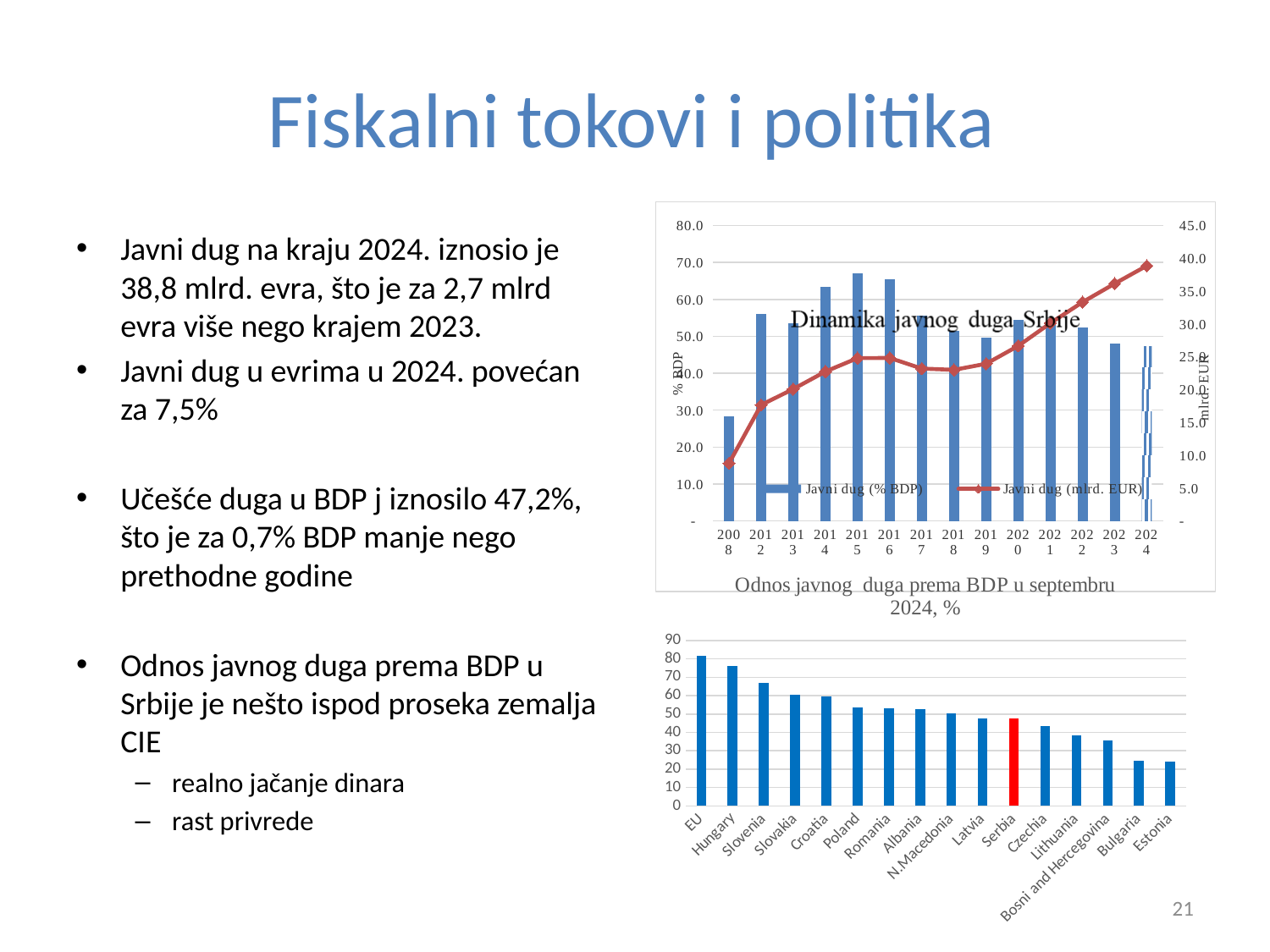
In the bottom chart 'Odnos javnog duga prema BDP u septembru 2024, %', is the value for Serbia greater or less than 50? less In the bottom chart 'Odnos javnog duga prema BDP u septembru 2024, %', how many countries/categories are shown? 16 In the bottom chart 'Odnos javnog duga prema BDP u septembru 2024, %', which is larger, the value for Hungary or the value for Slovenia? Hungary In the top chart 'Dinamika javnog duga Srbije', is the 'Javni dug (% BDP)' bar for 2024 greater or less than 50.0? less In the bottom chart 'Odnos javnog duga prema BDP u septembru 2024, %', is the value for Hungary greater or less than 70? greater In the bottom chart 'Odnos javnog duga prema BDP u septembru 2024, %', which country's bar is coloured red? Serbia In the top chart 'Dinamika javnog duga Srbije', how many years are shown on the x axis? 14 In the top chart 'Dinamika javnog duga Srbije', how many series does the legend list? 2 What kind of chart is the bottom chart titled 'Odnos javnog duga prema BDP u septembru 2024, %'? bar chart In the bottom chart 'Odnos javnog duga prema BDP u septembru 2024, %', which category has the highest value? EU In the top chart 'Dinamika javnog duga Srbije', does the line 'Javni dug (mlrd. EUR)' generally rise or fall from 2008 to 2024? rise